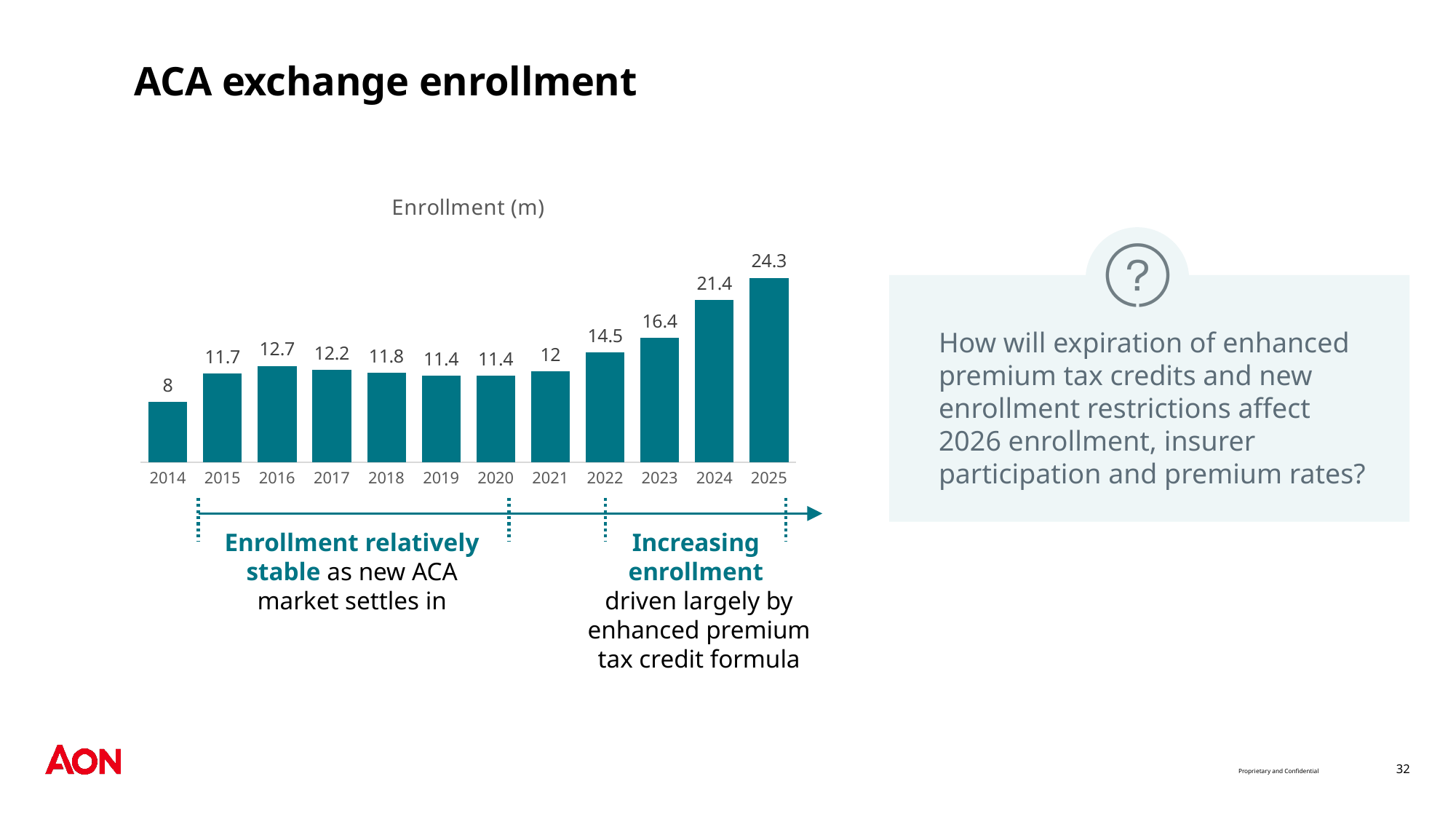
Do enrollment values rise or fall from 2021 to 2025? Rise What is the title of the chart? Enrollment (m) Which year has the lowest enrollment? 2014 Which year has the highest enrollment? 2025 What is the difference in enrollment between 2025 and 2024? 2.9 What is the difference in enrollment between 2023 and 2022? 1.9 What kind of chart is shown on the slide? Bar chart Which year has higher enrollment, 2016 or 2021? 2016 What is the enrollment value for 2014? 8 What is the enrollment value for 2025? 24.3 How many years are shown on the chart? 12 What is the enrollment value for 2022? 14.5